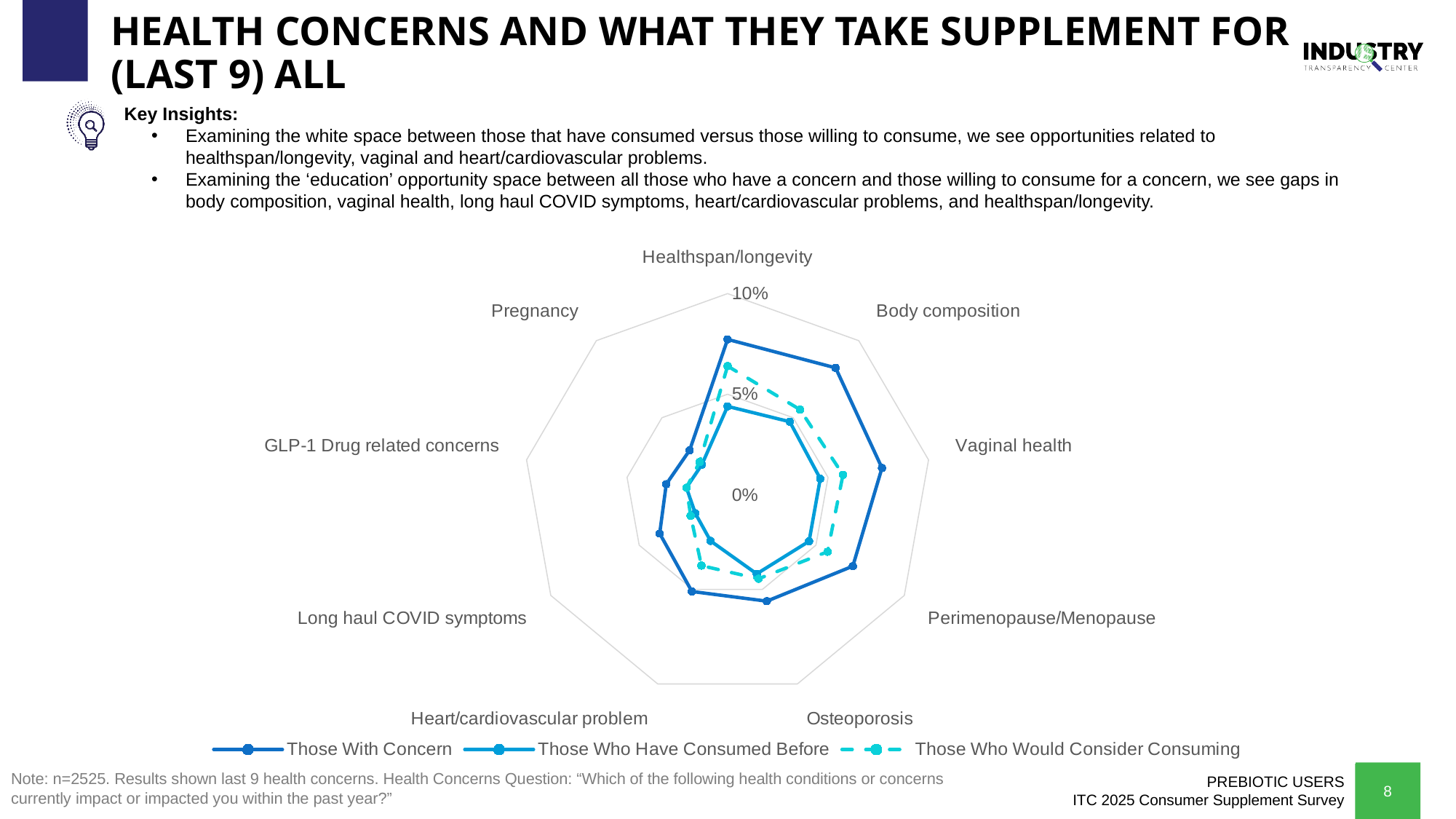
Is the value for Pregnancy in the Those With Concern series greater or less than 5%? less How many series does the legend of the radar chart list? 3 What kind of chart is shown on the slide? Radar chart In the Those Who Would Consider Consuming series, which category has the highest value? Healthspan/longevity For Vaginal health, which series has the larger value: Those With Concern or Those Who Have Consumed Before? Those With Concern Is the value for Body composition in the Those With Concern series greater or less than 5%? greater What is the highest percentage tick shown on the radar chart's axis? 10% Which series on the radar chart is drawn with a dashed line? Those Who Would Consider Consuming Is the value for Heart/cardiovascular problem in the Those Who Have Consumed Before series greater or less than 5%? less How many health concern categories are plotted on the radar chart? 9